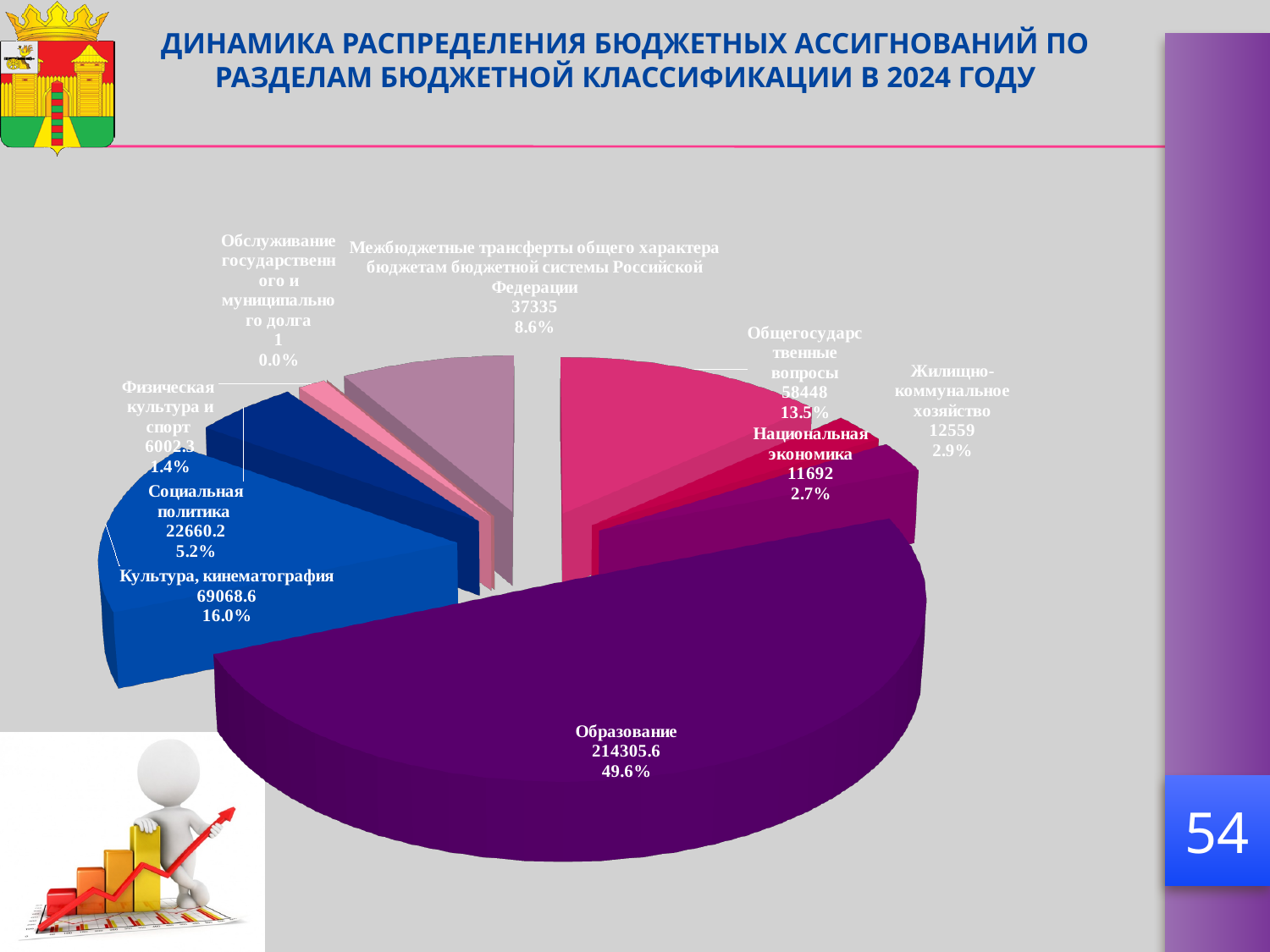
What share of the pie does Межбюджетные трансферты общего характера бюджетам бюджетной системы Российской Федерации represent? 8.6% What is the difference between the values for Образование and Культура, кинематография? 145237 What share of the pie does Образование represent? 49.6% Which category has the smallest value? Обслуживание государственного и муниципального долга What is the value for Социальная политика? 22660.2 What is the value for Культура, кинематография? 69068.6 Which category has the largest share of the pie? Образование How many categories are shown in the pie chart? 9 What share of the pie does Общегосударственные вопросы represent? 13.5% What kind of chart is shown on the slide? Pie chart What is the value for Образование? 214305.6 Which is larger, the value for Жилищно-коммунальное хозяйство or the value for Национальная экономика? Жилищно-коммунальное хозяйство